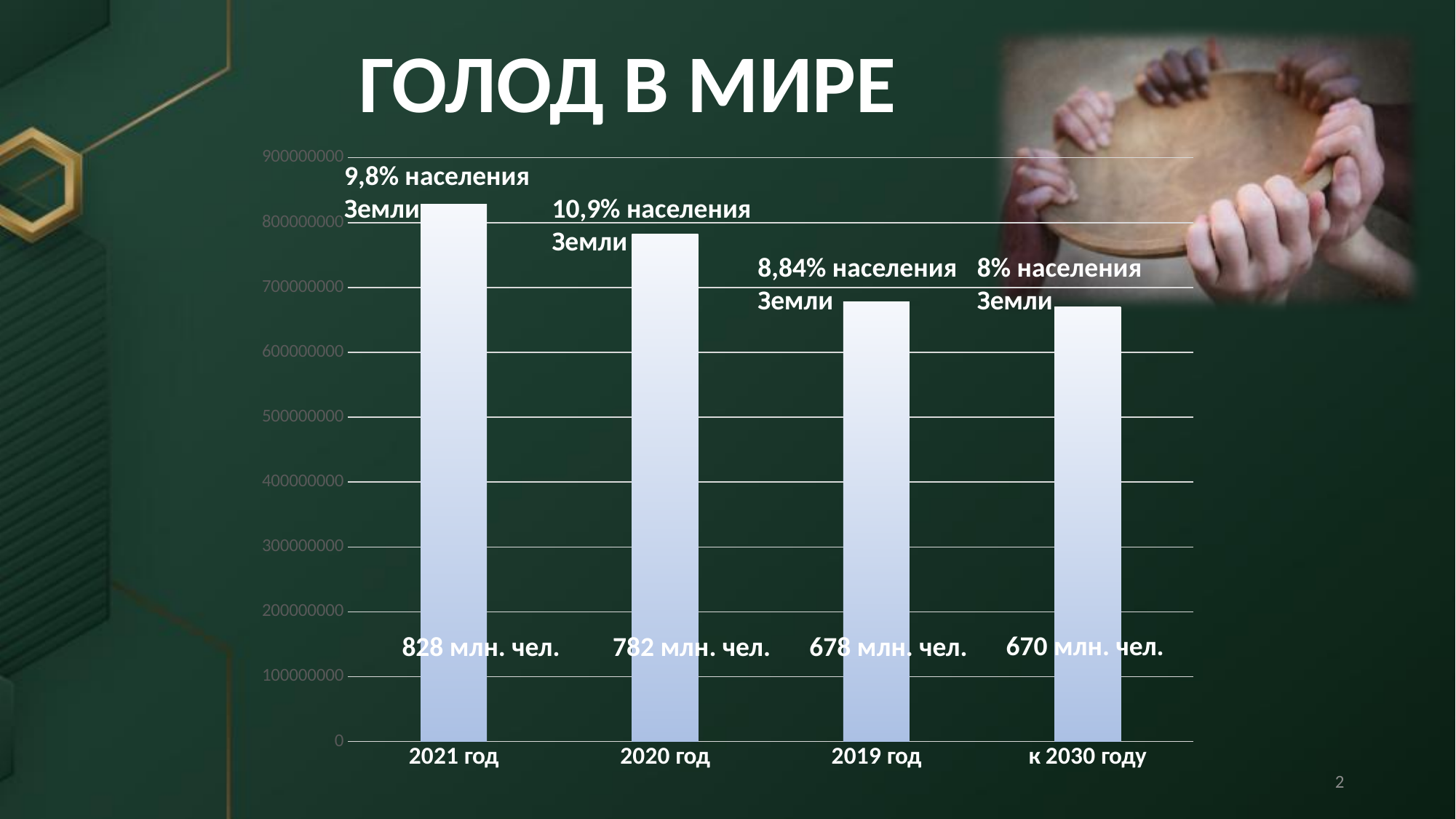
What value is labelled on the bar for 2021 год? 828 млн. чел. Which category has the highest bar? 2021 год Which category has the lowest bar? к 2030 году What is the title of the slide's chart? ГОЛОД В МИРЕ What is the difference between the values for 2021 год and 2020 год? 46 млн. чел. How many bars (categories) does the chart show? 4 What value is labelled on the bar for 2020 год? 782 млн. чел. Is the value for 2019 год greater or less than 700000000? less What share of the Earth's population is given above the bar for 2020 год? 10,9% населения Земли What value is labelled on the bar for к 2030 году? 670 млн. чел. What kind of chart is shown on the slide? bar chart What value is labelled on the bar for 2019 год? 678 млн. чел.